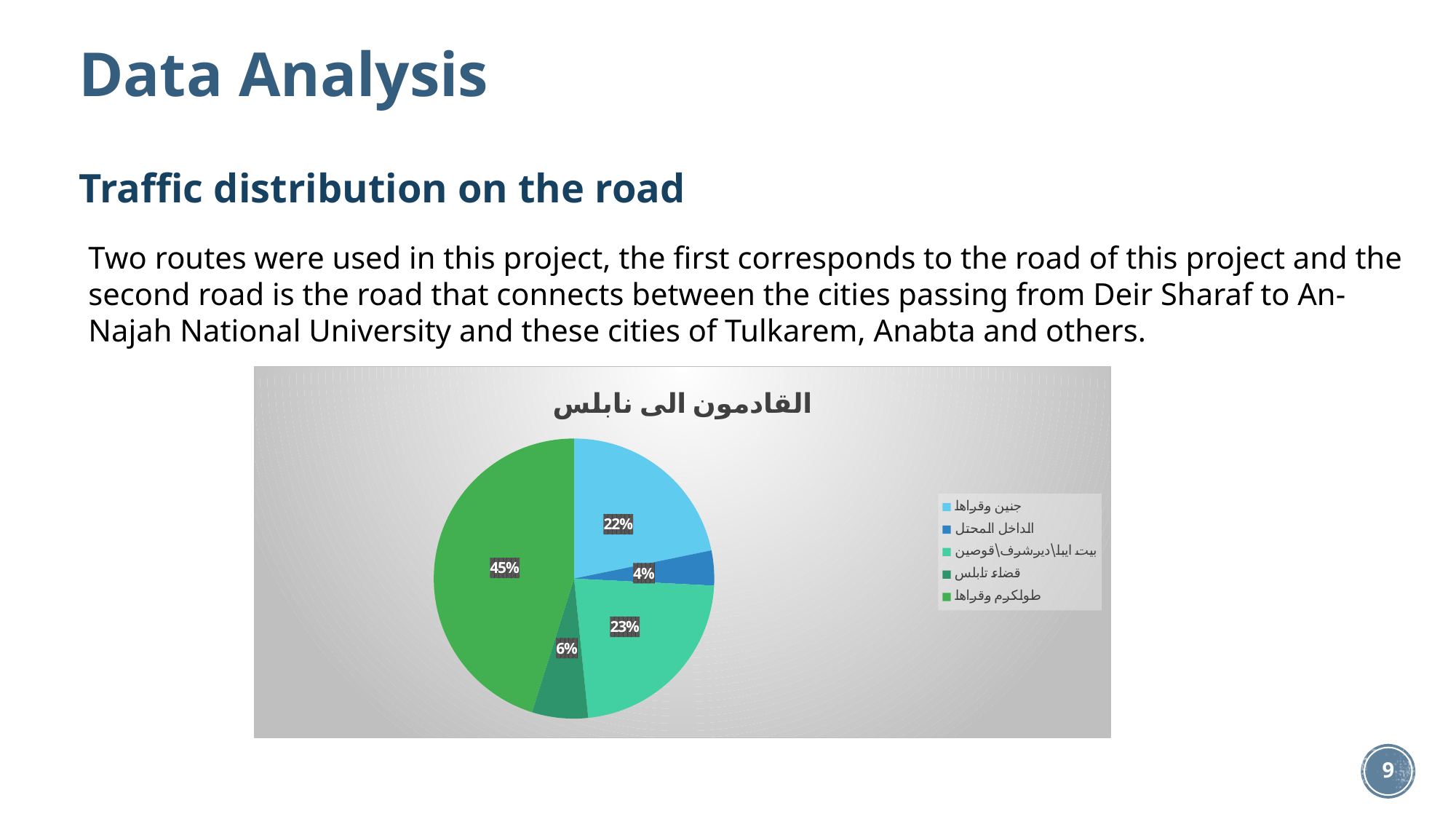
What is the difference in percentage points between the slices for طولكرم وقراها and بيت ايبا\ديرشرف\قوصين? 22% What share of the pie does جنين وقراها have? 22% What kind of chart is shown on the slide? pie chart What share of the pie does الداخل المحتل have? 4% How many slices does the pie chart have? 5 What is the title of the pie chart? القادمون الى نابلس How many entries does the legend of the pie chart list? 5 What share of the pie does قضاء نابلس have? 6% Which slice is larger: قضاء نابلس or الداخل المحتل? قضاء نابلس Which category has the smallest slice of the pie? الداخل المحتل Which category has the largest slice of the pie? طولكرم وقراها